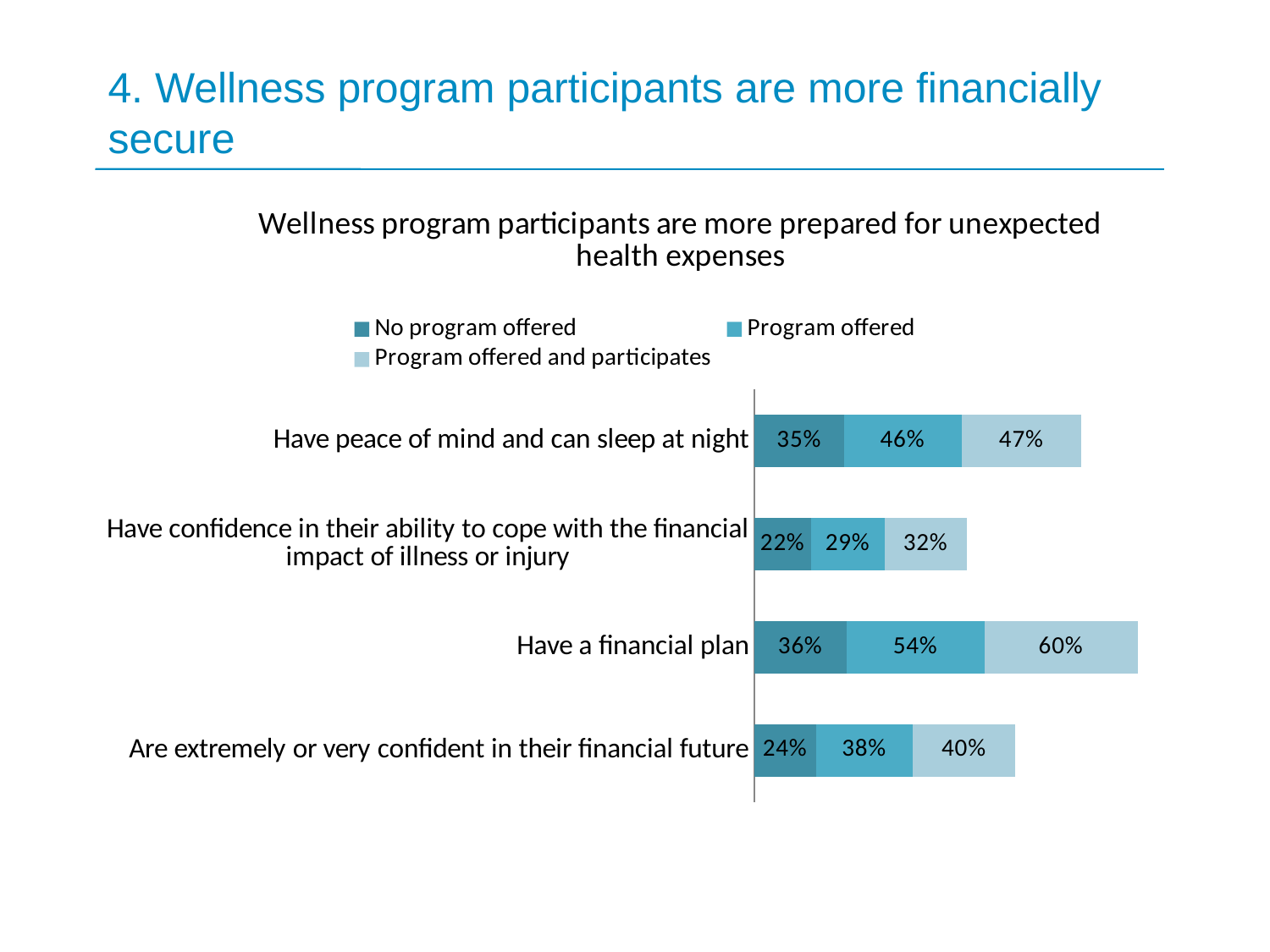
Which category has the highest value for 'Program offered and participates'? Have a financial plan What is the difference between the 'Program offered' and 'No program offered' values for 'Are extremely or very confident in their financial future'? 14% What percentage of the 'No program offered' group have a financial plan? 36% What percentage of the 'Program offered' group are extremely or very confident in their financial future? 38% Which category has the lowest value for 'No program offered'? Have confidence in their ability to cope with the financial impact of illness or injury What kind of chart is shown on the slide? Stacked bar chart How many categories are shown on the chart? 4 What is the value for 'Program offered and participates' for 'Have peace of mind and can sleep at night'? 47% What is the 'No program offered' value for 'Have confidence in their ability to cope with the financial impact of illness or injury'? 22% What is the difference between the 'Program offered and participates' and 'No program offered' values for 'Have a financial plan'? 24% How many series does the legend list? 3 For 'Have peace of mind and can sleep at night', which is larger: the 'No program offered' value or the 'Program offered' value? Program offered